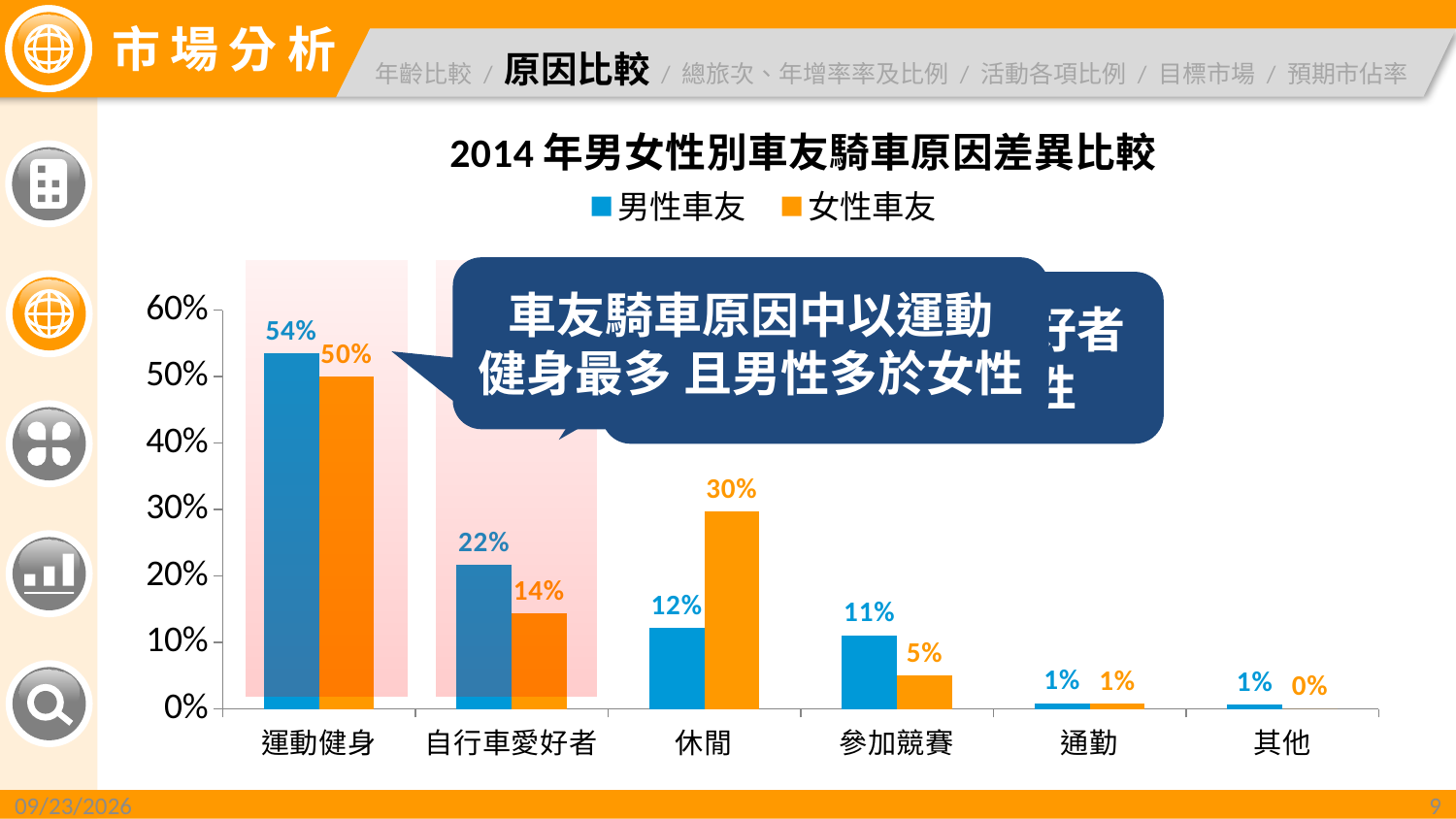
Which category has the lowest value for 女性車友? 其他 What is the value for 女性車友 in the 休閒 category? 30% In the 休閒 category, which series has the larger value, 男性車友 or 女性車友? 女性車友 What is the value for 女性車友 in the 參加競賽 category? 5% Is the value for 女性車友 in the 運動健身 category greater or less than 40%? greater How many categories are shown on the x axis? 6 Which category has the highest value for 男性車友? 運動健身 What is the title of the chart? 2014 年男女性別車友騎車原因差異比較 What is the difference between 男性車友 and 女性車友 in the 自行車愛好者 category? 8% What kind of chart is shown on the slide? bar chart How many series does the legend list? 2 What is the value for 男性車友 in the 運動健身 category? 54%